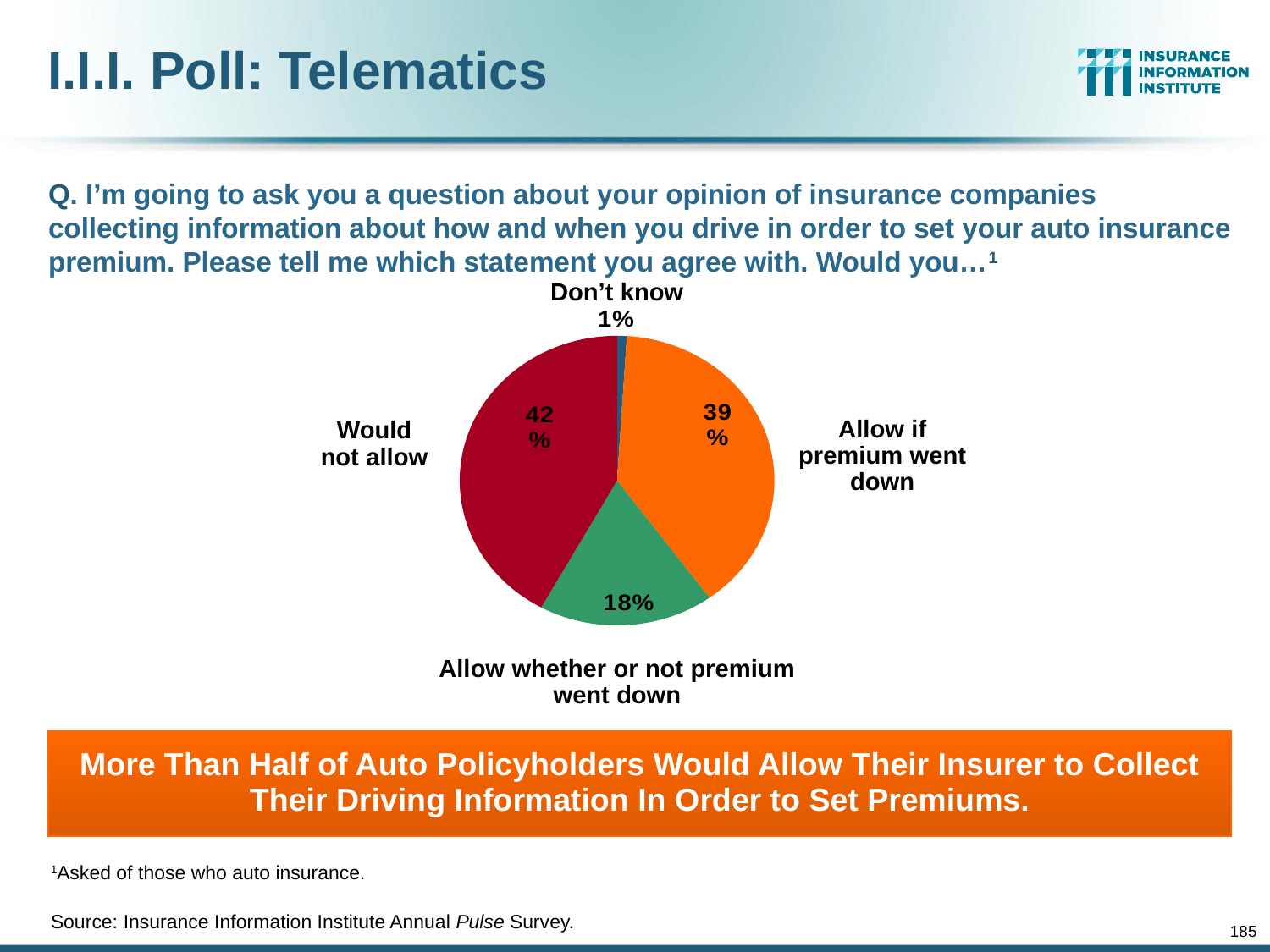
What share of respondents would allow data collection if their premium went down? 39% How many slices does the pie chart have? 4 What type of chart is shown on the slide? Pie chart What is the combined share of the two 'Allow' responses? 57% What colour is the 'Would not allow' slice? Red What percentage of respondents said they would not allow insurers to collect driving information? 42% What percentage would allow data collection whether or not their premium went down? 18% What percentage of respondents answered 'Don't know'? 1% Which is larger: the share for 'Allow if premium went down' or the share for 'Allow whether or not premium went down'? Allow if premium went down Which response has the largest share of the pie? Would not allow Which response has the smallest share of the pie? Don't know What is the difference in percentage points between 'Would not allow' and 'Allow if premium went down'? 3 percentage points